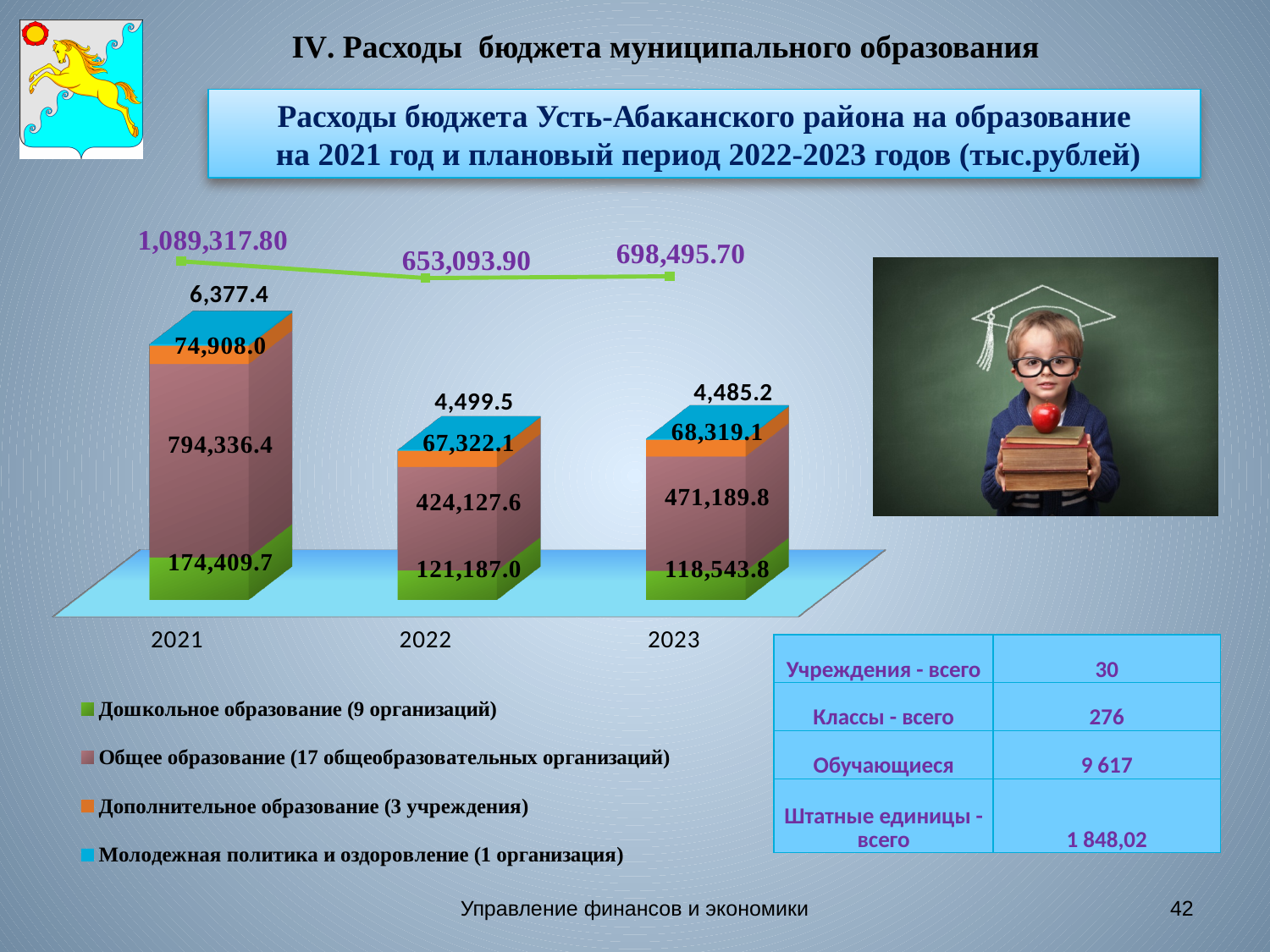
Which year has the larger value for Общее образование, 2022 or 2023? 2023 What is the value for Общее образование in 2021? 794,336.4 What is the difference between the Дополнительное образование values for 2021 and 2022? 7,585.9 How many series does the legend list? 4 What is the value for Молодежная политика и оздоровление in 2022? 4,499.5 In which year is the value for Общее образование the highest? 2021 How many years are shown on the x axis of the chart? 3 Does the value for Дошкольное образование rise or fall from 2021 to 2023? Fall What is the value for Дошкольное образование in 2023? 118,543.8 What value is printed on the line series above the 2021 bar? 1,089,317.80 In which year is the value for Дошкольное образование the lowest? 2023 What kind of chart is shown on the slide? Stacked bar chart with a line